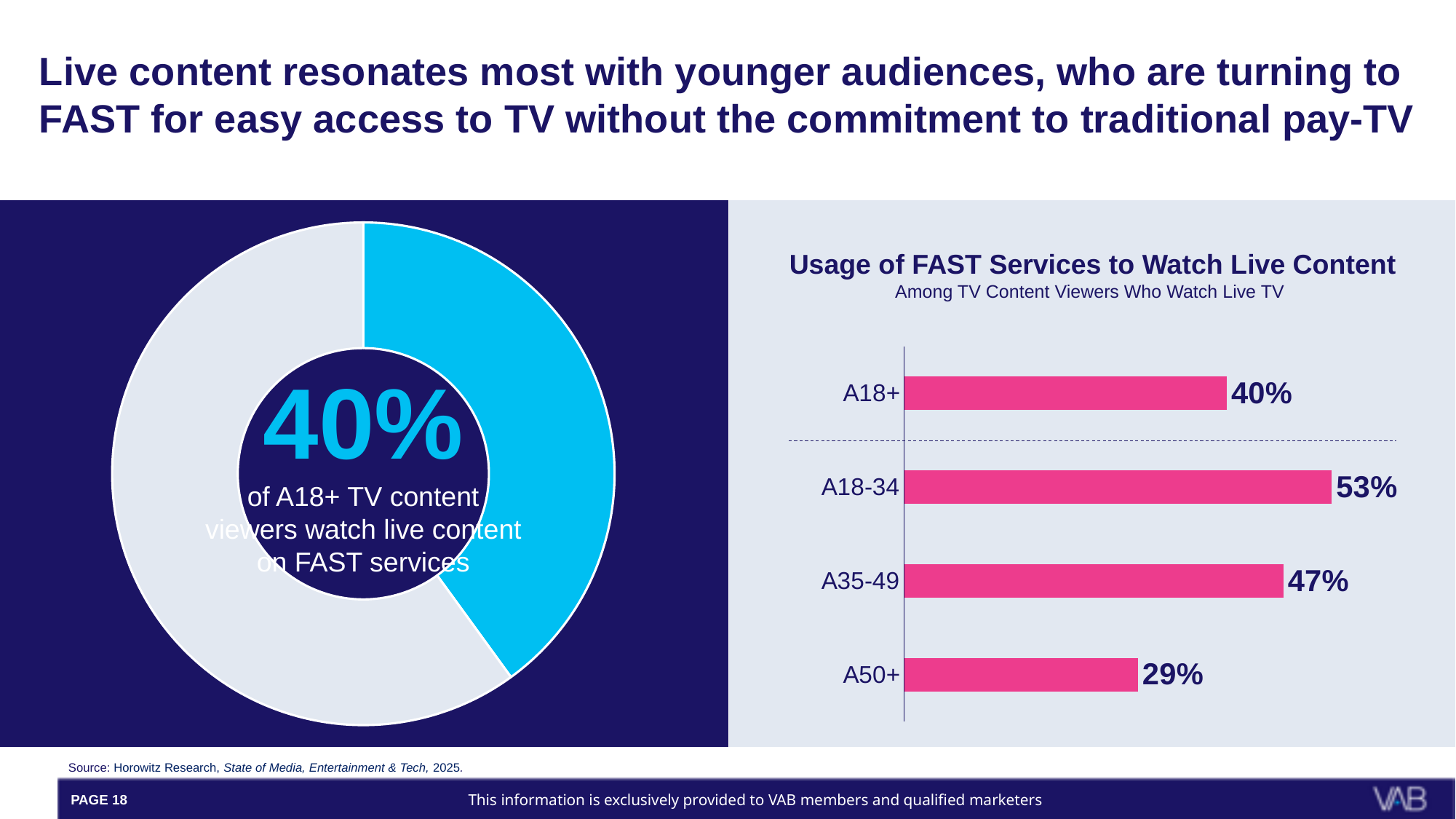
In the 'Usage of FAST Services to Watch Live Content' bar chart, which age group has the highest value? A18-34 In the 'Usage of FAST Services to Watch Live Content' bar chart, what is the value for A50+? 29% What kind of chart is the chart on the right side of the slide? Bar chart What is the subtitle of the 'Usage of FAST Services to Watch Live Content' bar chart? Among TV Content Viewers Who Watch Live TV In the 'Usage of FAST Services to Watch Live Content' bar chart, what is the difference between the A18-34 and A50+ values? 24% How many age groups are shown in the 'Usage of FAST Services to Watch Live Content' bar chart? 4 In the 'Usage of FAST Services to Watch Live Content' bar chart, what is the value for A35-49? 47% In the 'Usage of FAST Services to Watch Live Content' bar chart, which age group has the lowest value? A50+ In the donut chart on the left, what share of A18+ TV content viewers watch live content on FAST services? 40% In the 'Usage of FAST Services to Watch Live Content' bar chart, what is the value for A18-34? 53% In the 'Usage of FAST Services to Watch Live Content' bar chart, which is larger, the value for A35-49 or the value for A18+? A35-49 What kind of chart is the chart on the left side of the slide? Donut chart